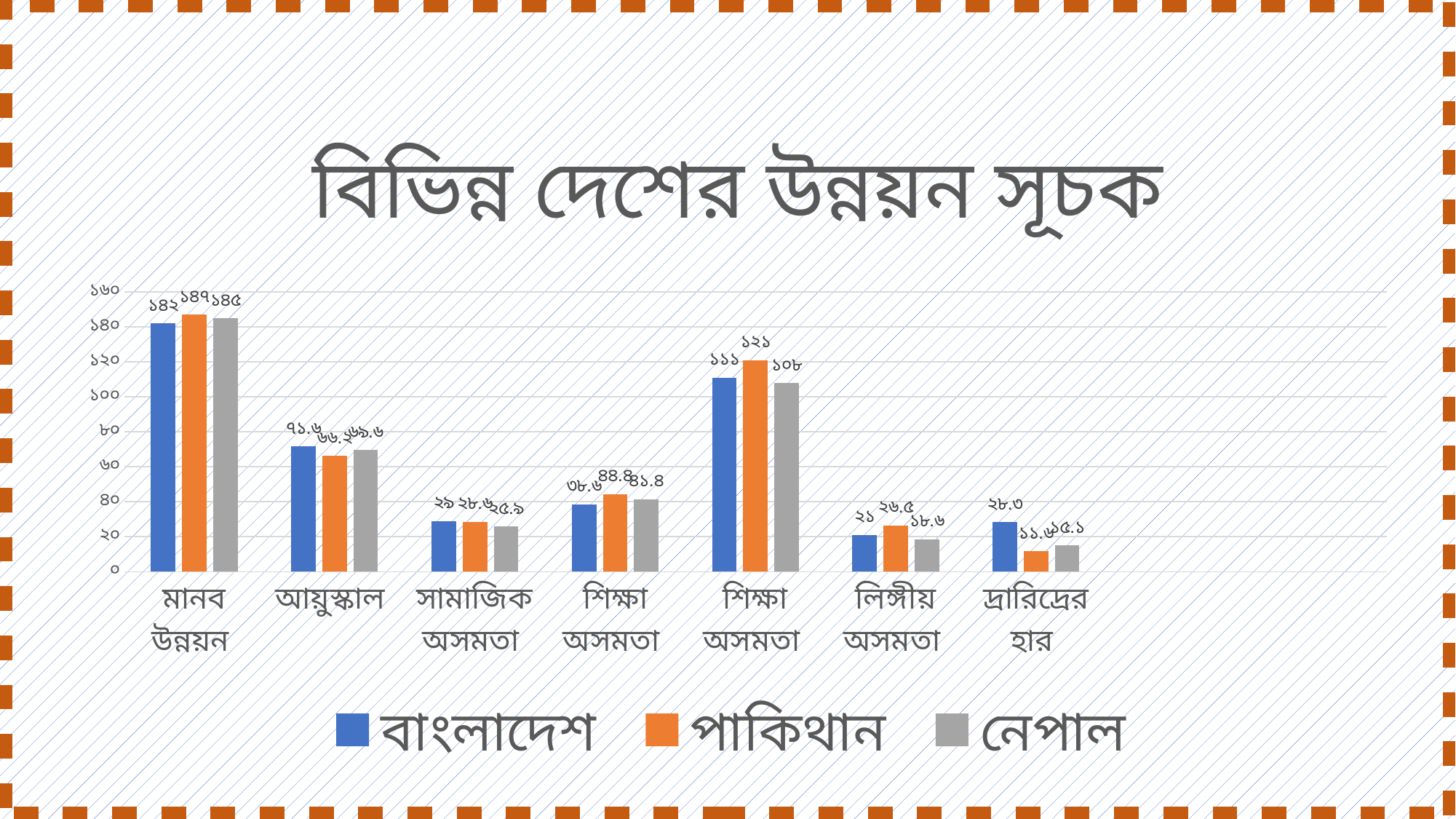
Which country has the lowest value in the দ্রারিদ্রের হার category? পাকিস্থান What is the title of the chart? বিভিন্ন দেশের উন্নয়ন সূচক How many series does the legend list? 3 How many categories are shown on the x axis? 7 What type of chart is shown on the slide? bar chart Which country has the highest value in the লিঙ্গীয় অসমতা category? পাকিস্থান What is the value for নেপাল in the fifth category (the second শিক্ষা অসমতা)? ১০৮ What is the value for বাংলাদেশ in the আয়ুষ্কাল category? ৭১.৬ What is the value for পাকিস্থান in the মানব উন্নয়ন category? ১৪৭ In the fifth category (the second শিক্ষা অসমতা), which is larger: the value for বাংলাদেশ or for পাকিস্থান? পাকিস্থান What is the value for বাংলাদেশ in the দ্রারিদ্রের হার category? ২৮.৩ What is the difference between the পাকিস্থান and বাংলাদেশ values in the মানব উন্নয়ন category? ৫